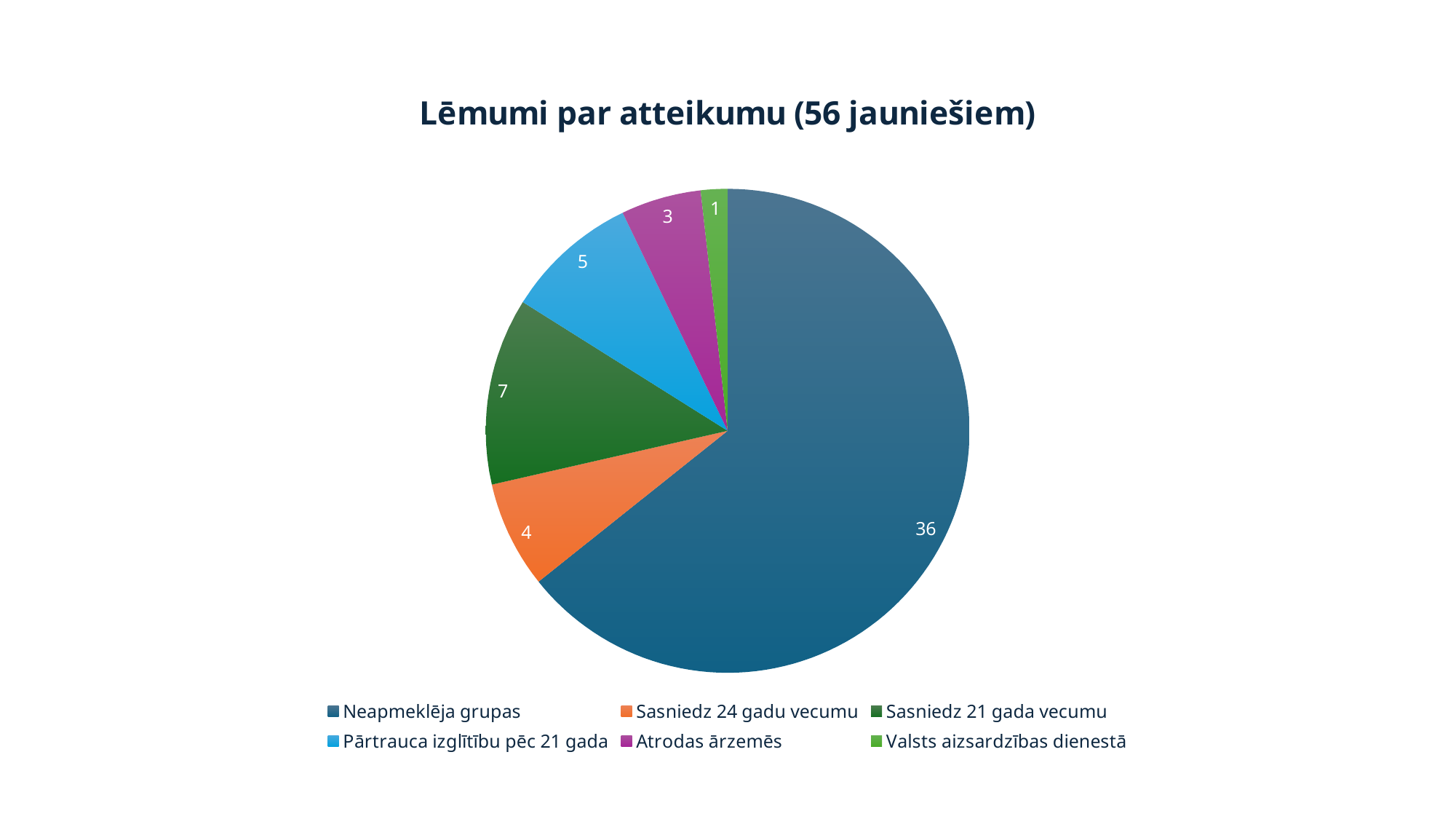
What is the value for "Sasniedz 21 gada vecumu"? 7 What type of chart is shown on the slide? pie chart What is the value for "Pārtrauca izglītību pēc 21 gada"? 5 How many categories does the pie chart have? 6 Which category has the smallest slice? Valsts aizsardzības dienestā What is the difference between the values for "Neapmeklēja grupas" and "Sasniedz 21 gada vecumu"? 29 What is the value for "Neapmeklēja grupas"? 36 What share of the pie does "Sasniedz 21 gada vecumu" represent? 12.5% What is the value for "Atrodas ārzemēs"? 3 What is the title of the chart? Lēmumi par atteikumu (56 jauniešiem) Which is larger, the value for "Sasniedz 24 gadu vecumu" or the value for "Pārtrauca izglītību pēc 21 gada"? Pārtrauca izglītību pēc 21 gada Which category has the largest slice? Neapmeklēja grupas